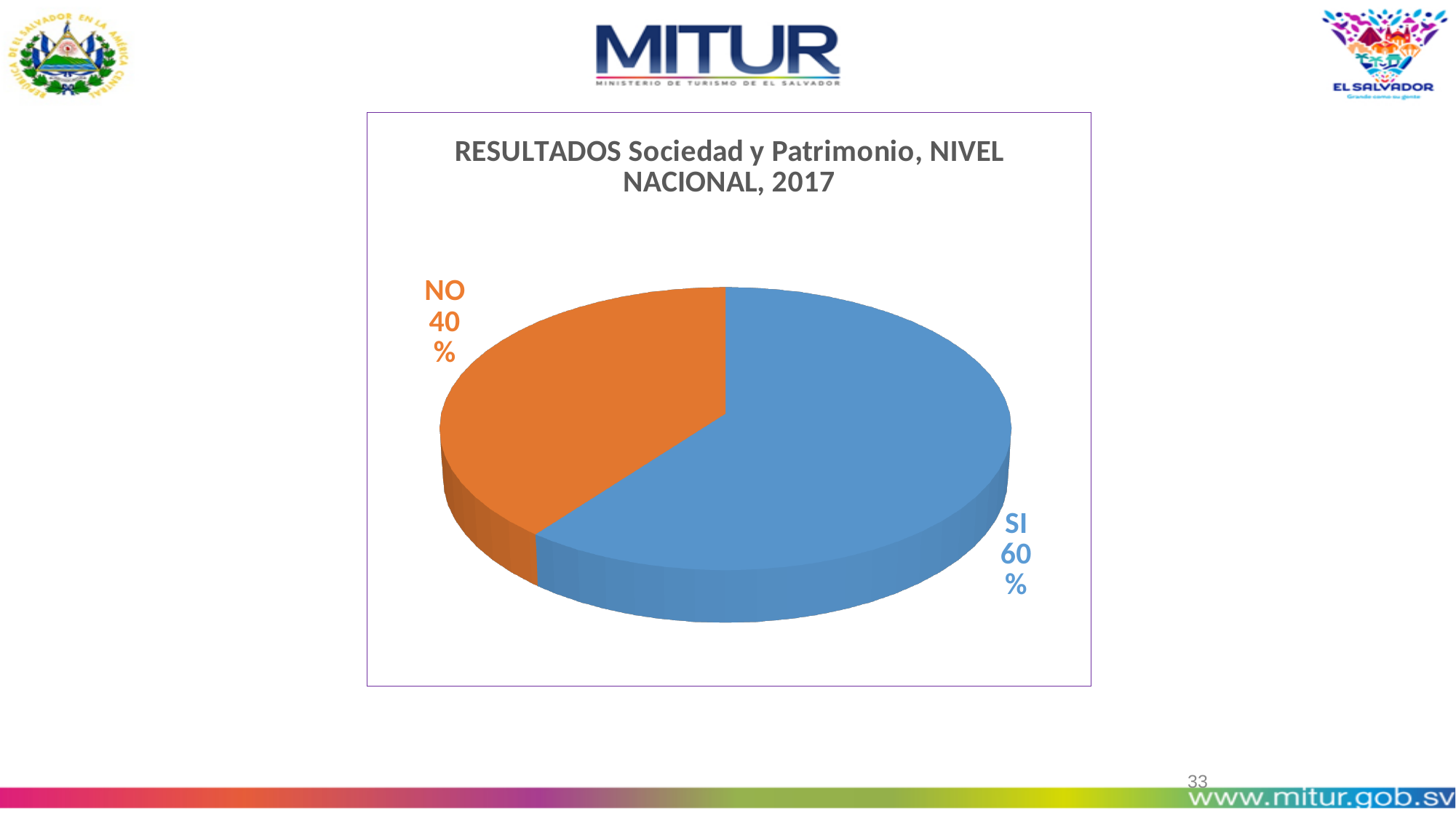
What is the difference in percentage points between the SI and NO slices? 20 How many slices does the pie chart have? 2 What is the title of the chart? RESULTADOS Sociedad y Patrimonio, NIVEL NACIONAL, 2017 What type of chart is shown on the slide? Pie chart What percentage does the NO slice represent? 40% What share of the pie does the NO slice take? 40% What percentage does the SI slice represent? 60% What colour is the SI slice? Blue Which category has the smallest share of the pie? NO Which slice is larger, SI or NO? SI Which category has the largest share of the pie? SI